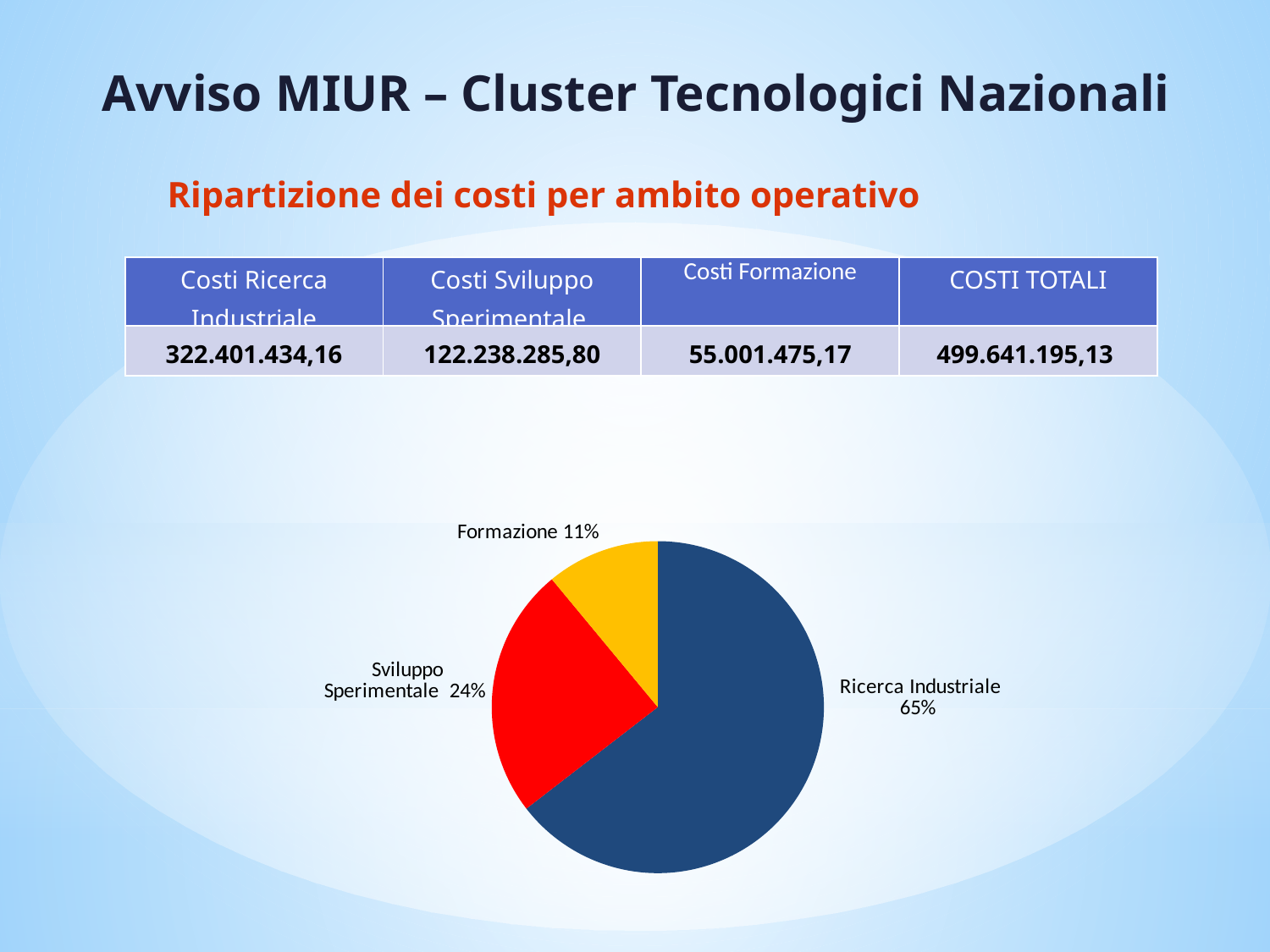
What share of the pie chart does Sviluppo Sperimentale represent? 24% Which slice of the pie chart is the smallest? Formazione What share of the pie chart does Formazione represent? 11% Which is larger in the pie chart, Sviluppo Sperimentale or Formazione? Sviluppo Sperimentale Which slice of the pie chart is the largest? Ricerca Industriale What is the difference in percentage points between the Ricerca Industriale slice and the Sviluppo Sperimentale slice? 41 percentage points What colour is the Ricerca Industriale slice in the pie chart? Dark blue What colour is the Formazione slice in the pie chart? Yellow What share of the pie chart does Ricerca Industriale represent? 65% What kind of chart is shown on the slide? Pie chart What is the difference in percentage points between the Sviluppo Sperimentale slice and the Formazione slice? 13 percentage points How many slices does the pie chart have? 3